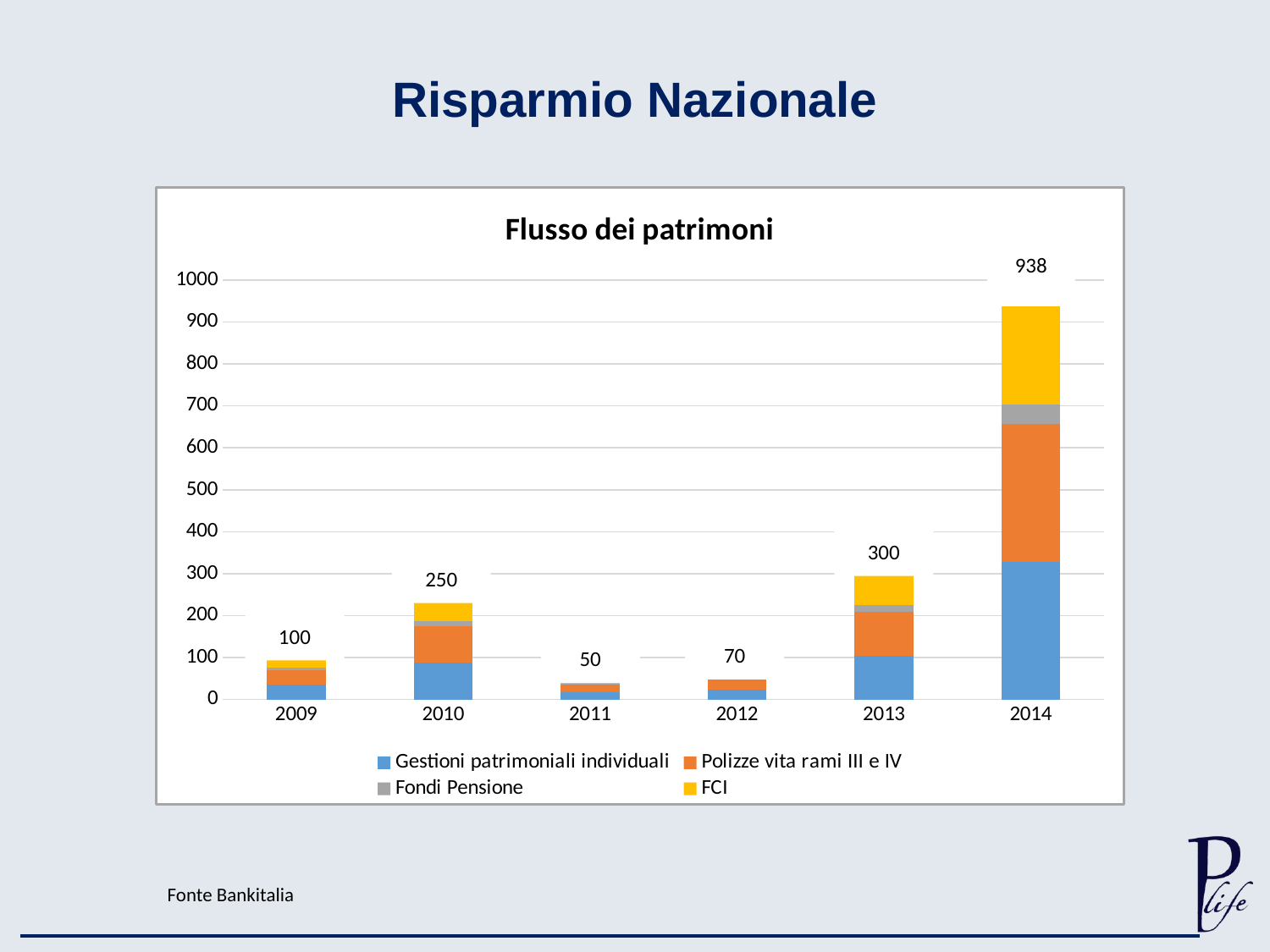
Which year has the highest labelled total? 2014 What is the total value labelled for 2012? 70 What is the difference between the labelled totals for 2014 and 2013? 638 How many years are shown on the x axis? 6 Which year has the larger labelled total, 2009 or 2012? 2009 Is the value of the Gestioni patrimoniali individuali segment for 2014 greater or less than 300? greater What type of chart is shown on the slide? Stacked bar chart What is the title of the chart? Flusso dei patrimoni How many series does the legend list? 4 What is the total value labelled for 2010? 250 Which year has the lowest labelled total? 2011 What is the total value labelled for 2014? 938